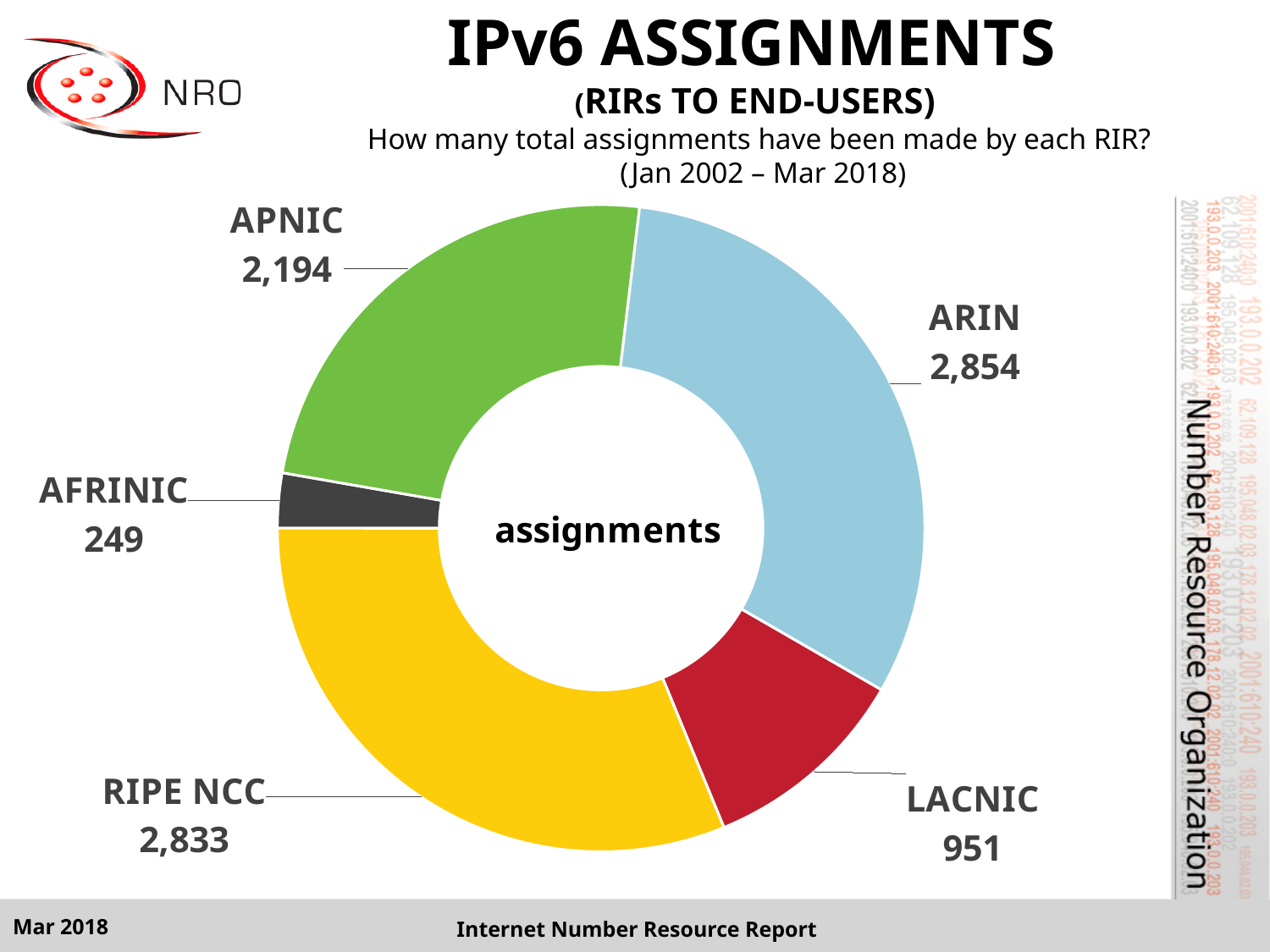
What type of chart is used on this slide? Donut (pie) chart What word is written in the centre of the donut chart? assignments How many RIRs are shown in the chart? 5 How many assignments are shown for LACNIC? 951 Which RIR has the lowest number of assignments? AFRINIC What is the difference between the assignments of ARIN and RIPE NCC? 21 How many IPv6 assignments has ARIN made according to the chart? 2,854 Which RIR has the highest number of assignments? ARIN What is the number of assignments shown for RIPE NCC? 2,833 Which has more assignments, LACNIC or AFRINIC? LACNIC What value is shown for AFRINIC? 249 How many more assignments has APNIC made than LACNIC? 1,243